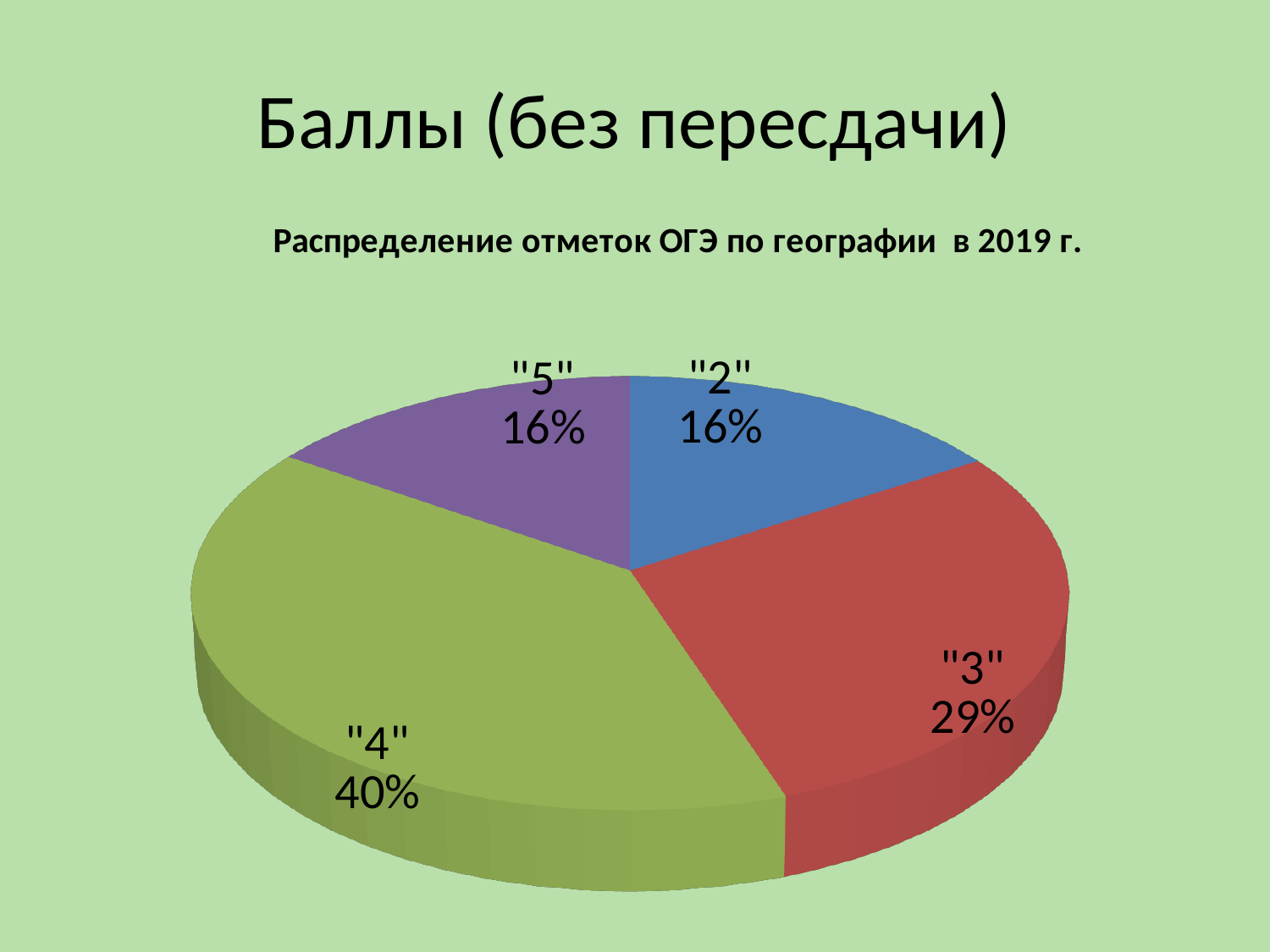
What is the difference in percentage points between the "4" slice and the "3" slice? 11 Which grade has the largest share of the pie? "4" What kind of chart is shown on the slide? Pie chart Which is larger, the share for "3" or the share for "5"? "3" What share of the pie does the "3" slice represent? 29% What share of the pie does the "2" slice represent? 16% What colour is the "3" slice? Red What is the title of the chart? Распределение отметок ОГЭ по географии в 2019 г. What share of the pie does the "5" slice represent? 16% What is the difference in percentage points between the "3" slice and the "2" slice? 13 How many slices does the pie chart have? 4